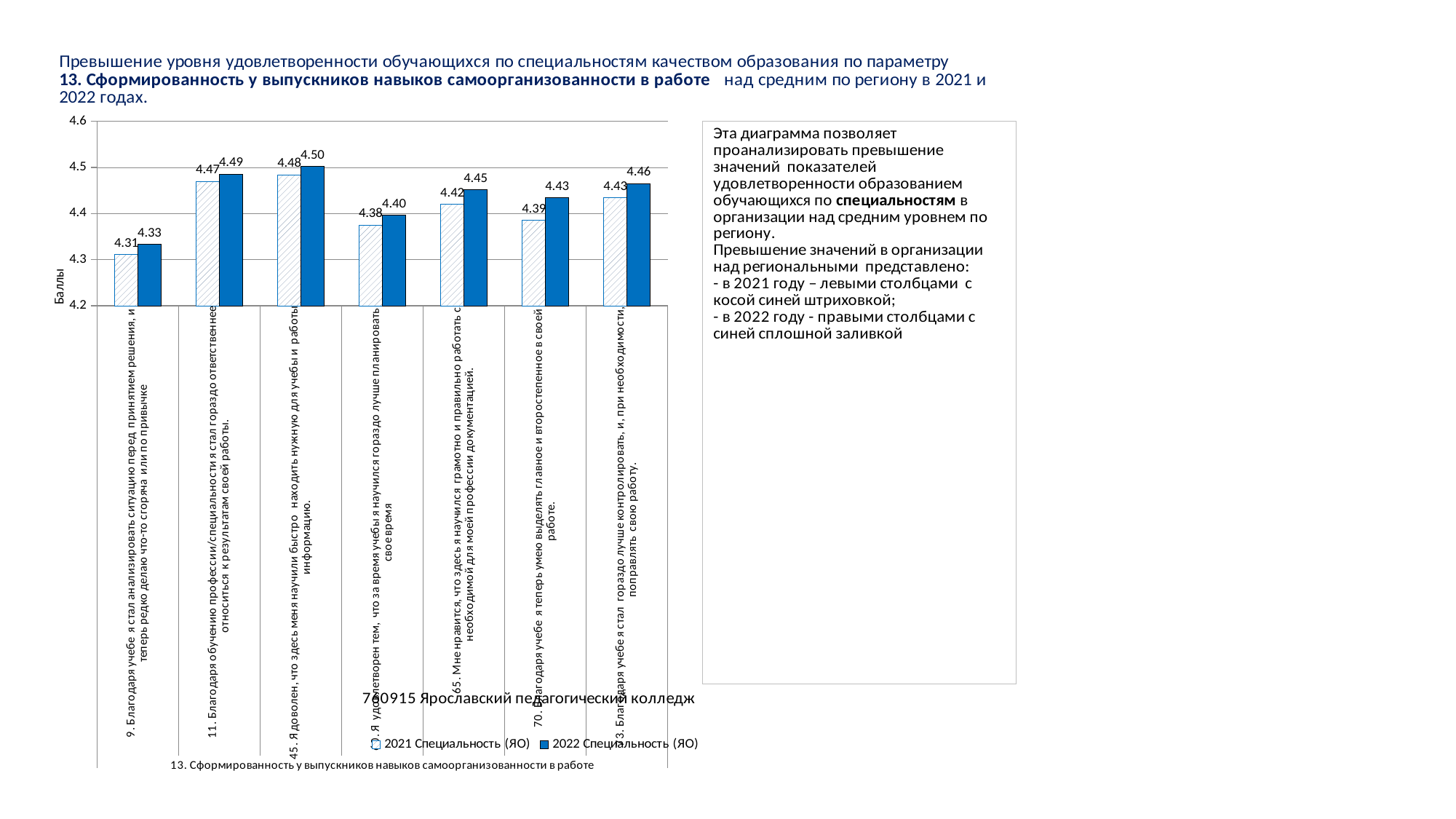
For category 65 (Мне нравится, что здесь я научился грамотно и правильно работать с необходимой для моей профессии документацией), which is larger: the 2021 value or the 2022 value? 2022 Специальность (ЯО) How many categories are shown on the x axis of the chart? 7 What is the difference between the 2022 and 2021 values for category 45 (Я доволен, что здесь меня научили быстро находить нужную для учебы и работы информацию)? 0.02 What is the 2022 Специальность (ЯО) value for category 9 (Благодаря учебе я стал анализировать ситуацию перед принятием решения)? 4.33 What is the 2021 Специальность (ЯО) value for category 11 (Благодаря обучению профессии/специальности я стал гораздо ответственнее относиться к результатам своей работы)? 4.47 What is the 2022 Специальность (ЯО) value for category 70 (Благодаря учебе я теперь умею выделять главное и второстепенное в своей работе)? 4.43 What kind of chart is shown on the slide? bar chart Which category has the lowest 2021 Специальность (ЯО) value? 9. Благодаря учебе я стал анализировать ситуацию перед принятием решения, и теперь редко делаю что-то сгоряча или по привычке Is the 2021 Специальность (ЯО) value for category 9 greater or less than 4.4? less What is the label of the vertical axis of the chart? Баллы Which category has the highest 2022 Специальность (ЯО) value? 45. Я доволен, что здесь меня научили быстро находить нужную для учебы и работы информацию. How many series does the chart legend list? 2